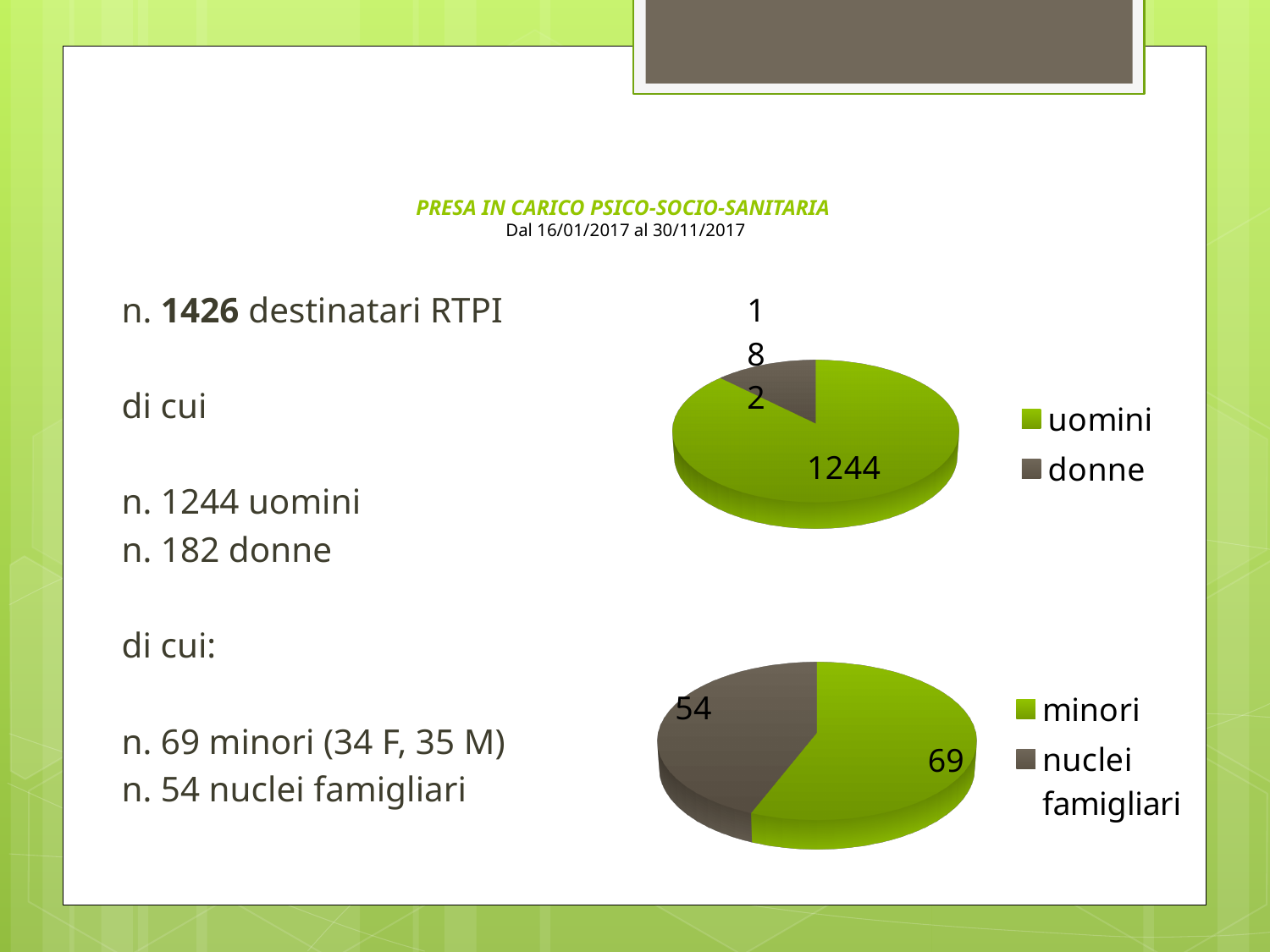
In the top pie chart, what is the value for uomini? 1244 How many categories does the legend of the bottom pie chart list? 2 In the bottom pie chart, which is larger, minori or nuclei famigliari? minori In the bottom pie chart, what is the difference between the values for minori and nuclei famigliari? 15 In the top pie chart, what is the difference between the values for uomini and donne? 1062 In the bottom pie chart, which category has the smallest slice? nuclei famigliari In the top pie chart, which category has the largest slice? uomini In the top pie chart, what is the total of the two slices? 1426 In the top pie chart, what is the value for donne? 182 In the bottom pie chart, what is the value for minori? 69 What type of chart is the top chart on the slide? pie chart In the bottom pie chart, what is the value for nuclei famigliari? 54